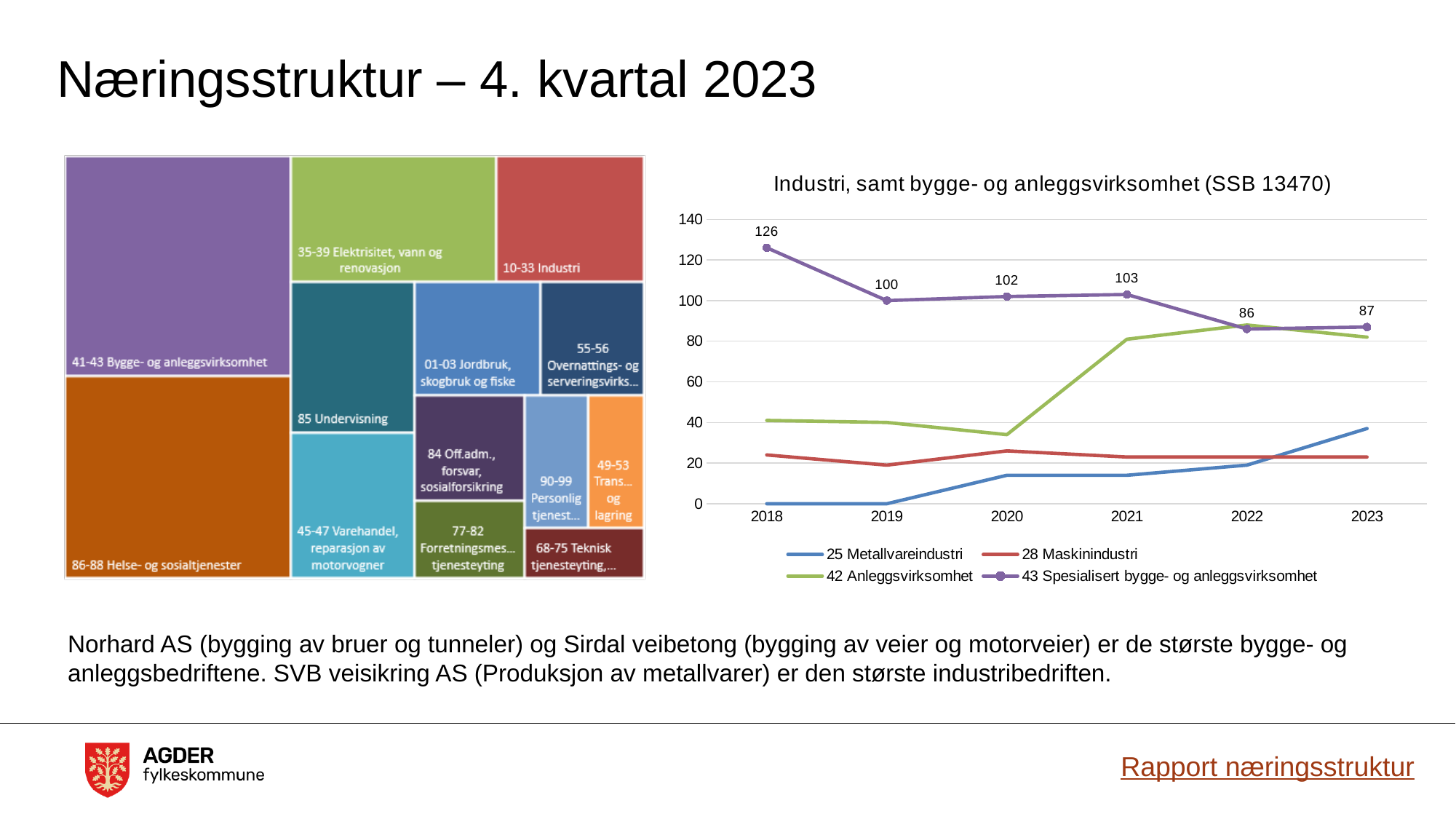
In the line chart on the right, is the value for 42 Anleggsvirksomhet in 2018 greater or less than 60? less In the line chart on the right, in which year is 43 Spesialisert bygge- og anleggsvirksomhet lowest? 2022 How many years are shown on the x axis of the line chart on the right? 6 In the line chart on the right, what is the difference between the 2021 and 2022 values for 43 Spesialisert bygge- og anleggsvirksomhet? 17 In the line chart titled "Industri, samt bygge- og anleggsvirksomhet (SSB 13470)", what is the value for 43 Spesialisert bygge- og anleggsvirksomhet in 2018? 126 How many series does the legend of the line chart on the right list? 4 In the line chart on the right, is the value for 25 Metallvareindustri in 2023 greater or less than 20? greater In the line chart on the right, what is the value for 43 Spesialisert bygge- og anleggsvirksomhet in 2023? 87 In the line chart on the right, does the value for 43 Spesialisert bygge- og anleggsvirksomhet rise or fall overall from 2018 to 2023? fall In the line chart on the right, in which year is 43 Spesialisert bygge- og anleggsvirksomhet highest? 2018 In the line chart on the right, which series has the larger value in 2022: 42 Anleggsvirksomhet or 28 Maskinindustri? 42 Anleggsvirksomhet In the line chart on the right, by how much did 43 Spesialisert bygge- og anleggsvirksomhet fall from 2018 to 2023? 39